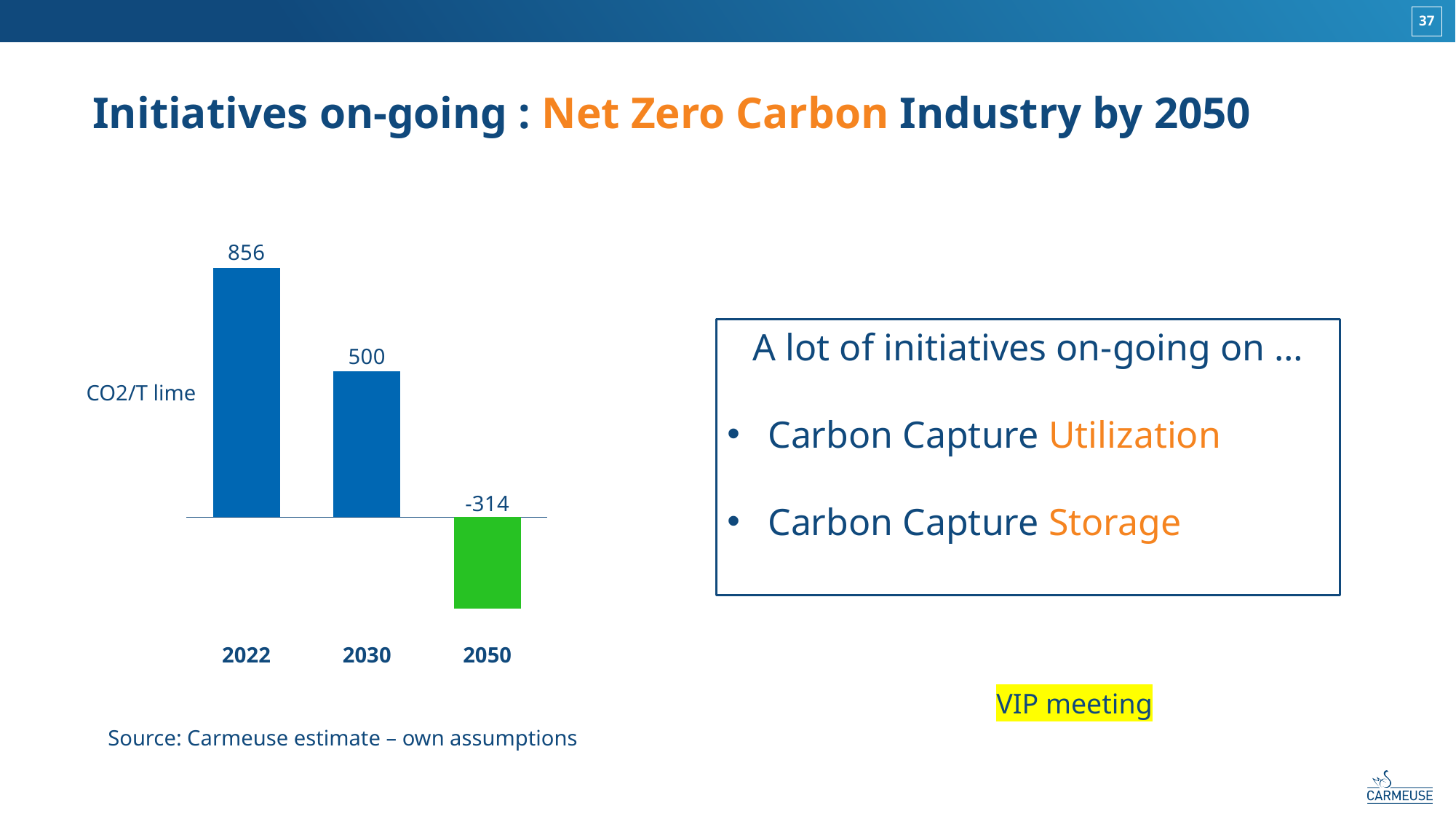
What kind of chart is shown on the slide? bar chart Do the values rise or fall from 2022 to 2050? fall Which bar on the chart is green? 2050 Which year has the highest CO2/T lime value? 2022 What is the CO2/T lime value for 2050? -314 What is the CO2/T lime value for 2030? 500 How many years are shown on the chart? 3 Which is larger, the value for 2030 or the value for 2050? 2030 What unit label is shown next to the chart's bars? CO2/T lime Which year has the lowest CO2/T lime value? 2050 What is the CO2/T lime value for 2022? 856 What is the difference between the 2022 and 2030 values? 356